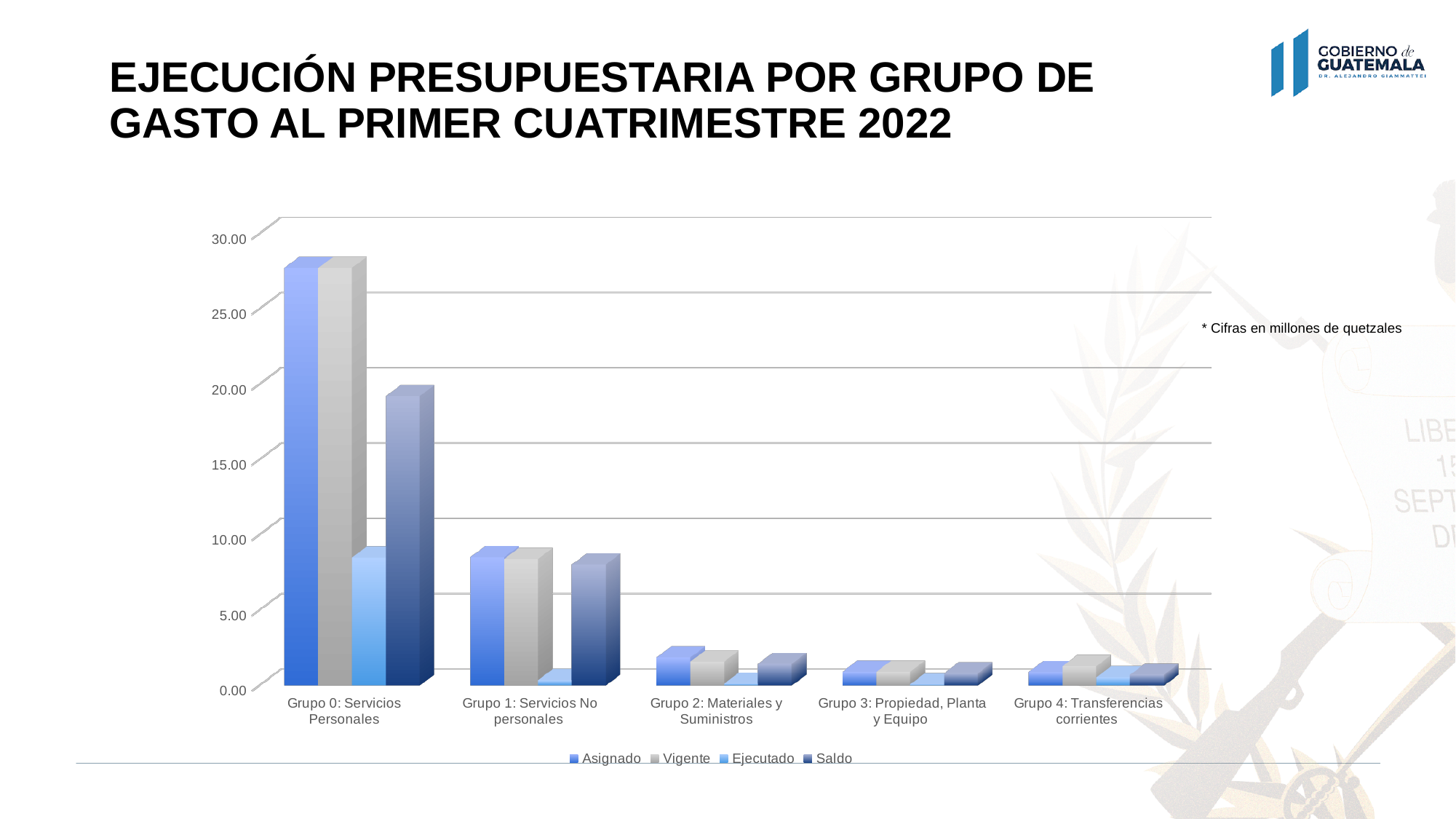
Is the Ejecutado value for Grupo 0: Servicios Personales greater or less than 10.00? less Is the Asignado value for Grupo 2: Materiales y Suministros greater or less than 5.00? less Is the Asignado value for Grupo 0: Servicios Personales greater or less than 25.00? greater How many expense groups (categories) are shown on the x axis? 5 Which is larger, the Asignado value for Grupo 0: Servicios Personales or for Grupo 1: Servicios No personales? Grupo 0: Servicios Personales What kind of chart is shown on the slide? bar chart Do the Asignado values generally rise or fall from Grupo 0 to Grupo 4 along the x axis? fall According to the note on the slide, in what units are the figures expressed? millones de quetzales How many series does the legend list? 4 Which category has the highest Asignado value? Grupo 0: Servicios Personales